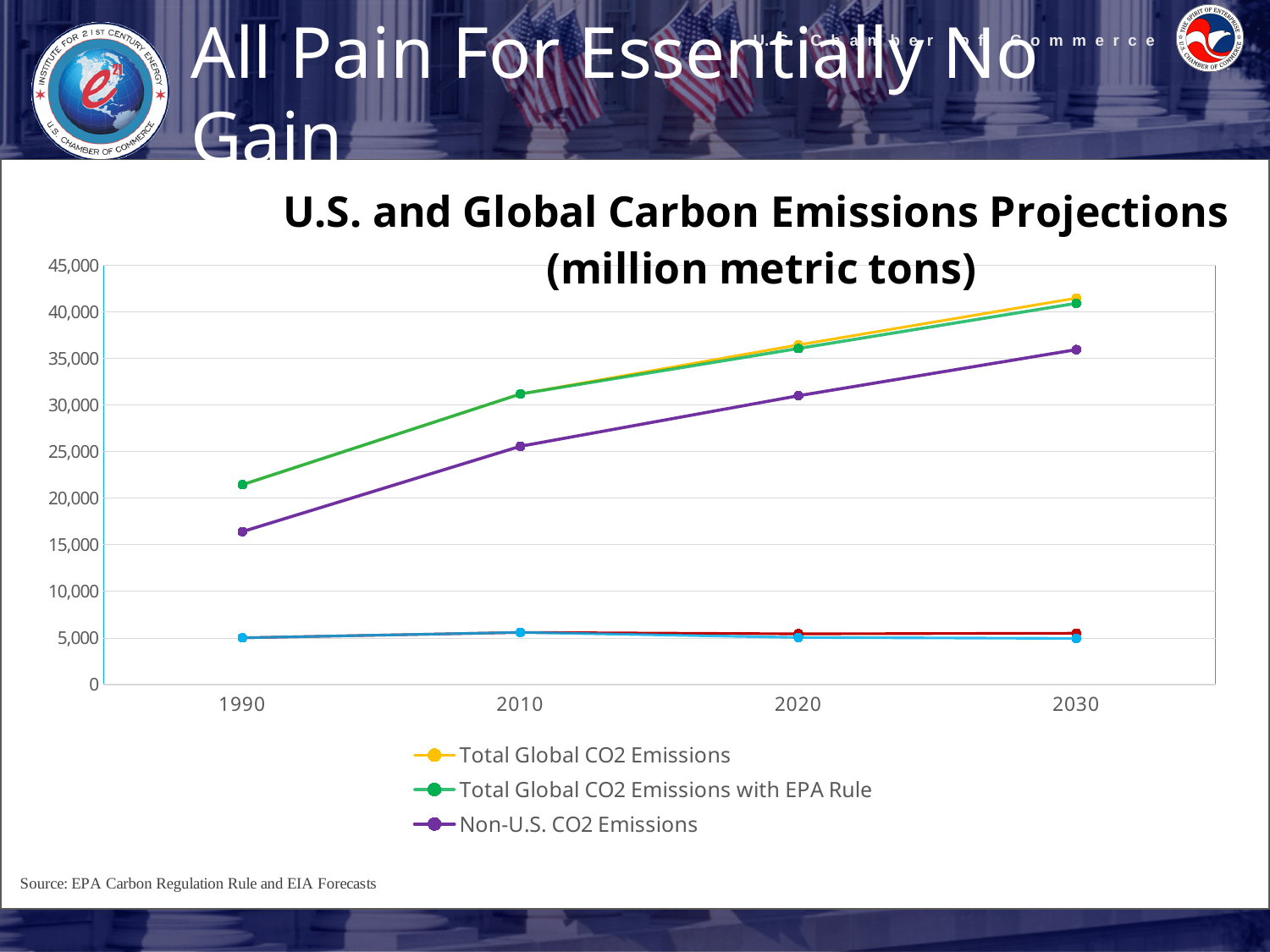
What kind of chart is shown on the slide? line chart How many series does the chart's legend list? 3 How many years are shown on the x axis of the chart? 4 Does the Non-U.S. CO2 Emissions line rise or fall from 1990 to 2030? rise In which year is Total Global CO2 Emissions lowest? 1990 Is the value for Total Global CO2 Emissions in 2030 greater or less than 40,000? greater In 2030, which is larger: Total Global CO2 Emissions or Non-U.S. CO2 Emissions? Total Global CO2 Emissions Is the value for Non-U.S. CO2 Emissions in 2020 greater or less than 35,000? less What is the title of the chart? U.S. and Global Carbon Emissions Projections (million metric tons) Is the value for Non-U.S. CO2 Emissions in 1990 greater or less than 15,000? greater In which year is Non-U.S. CO2 Emissions highest? 2030